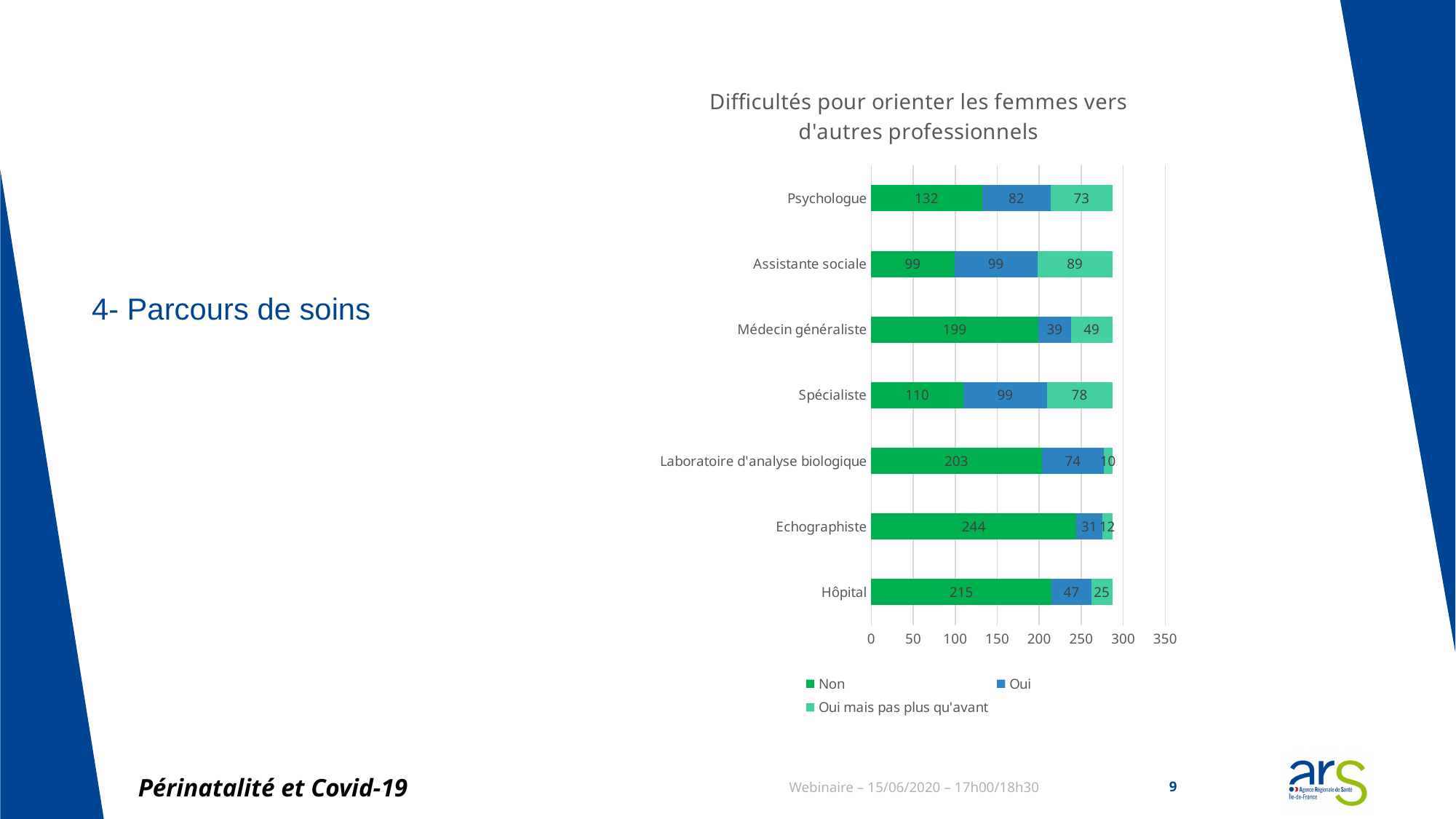
What is the value of the 'Oui' series for Psychologue? 82 What is the title of the chart? Difficultés pour orienter les femmes vers d'autres professionnels Which category has the lowest 'Oui mais pas plus qu'avant' value? Laboratoire d'analyse biologique How many categories are shown on the y axis? 7 Which is larger: the 'Oui' value for Spécialiste or the 'Oui' value for Laboratoire d'analyse biologique? Spécialiste What type of chart is shown on the slide? Stacked bar chart What is the total of the stacked bar for Psychologue? 287 How many series does the legend list? 3 What is the value of the 'Non' series for Echographiste? 244 Which category has the highest 'Non' value? Echographiste What is the difference between the 'Non' values for Hôpital and Médecin généraliste? 16 What is the value of the 'Oui mais pas plus qu'avant' series for Assistante sociale? 89